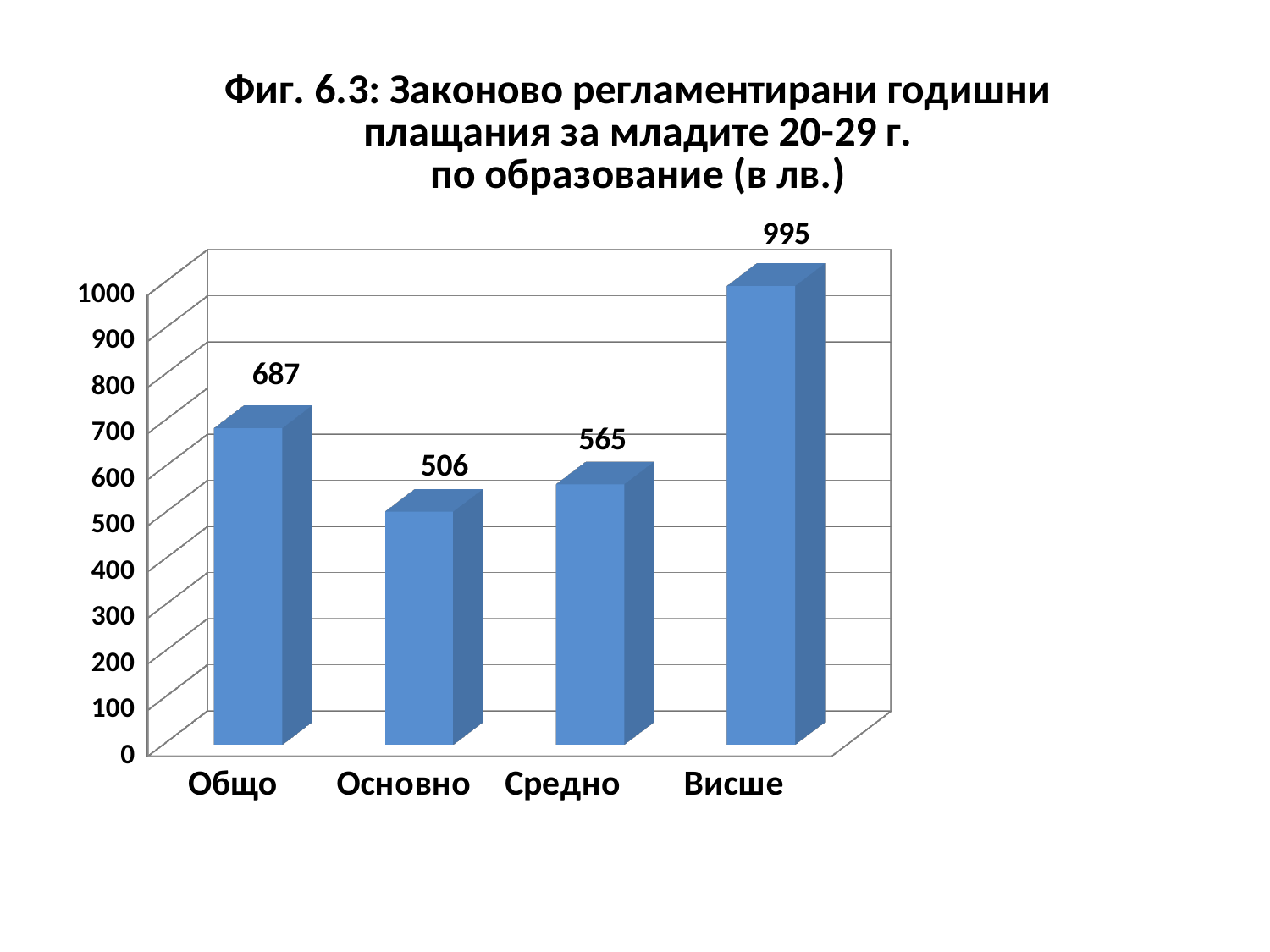
What is the highest value shown on the vertical axis? 1000 What is the value for Средно? 565 Which is larger, the value for Средно or the value for Основно? Средно What is the difference between the values for Висше and Основно? 489 What is the difference between the values for Общо and Средно? 122 Which category has the highest value? Висше What is the value for Висше? 995 What is the value for Основно? 506 What is the value for Общо? 687 How many categories are shown on the x axis? 4 What kind of chart is shown on the slide? Bar chart Which category has the lowest value? Основно